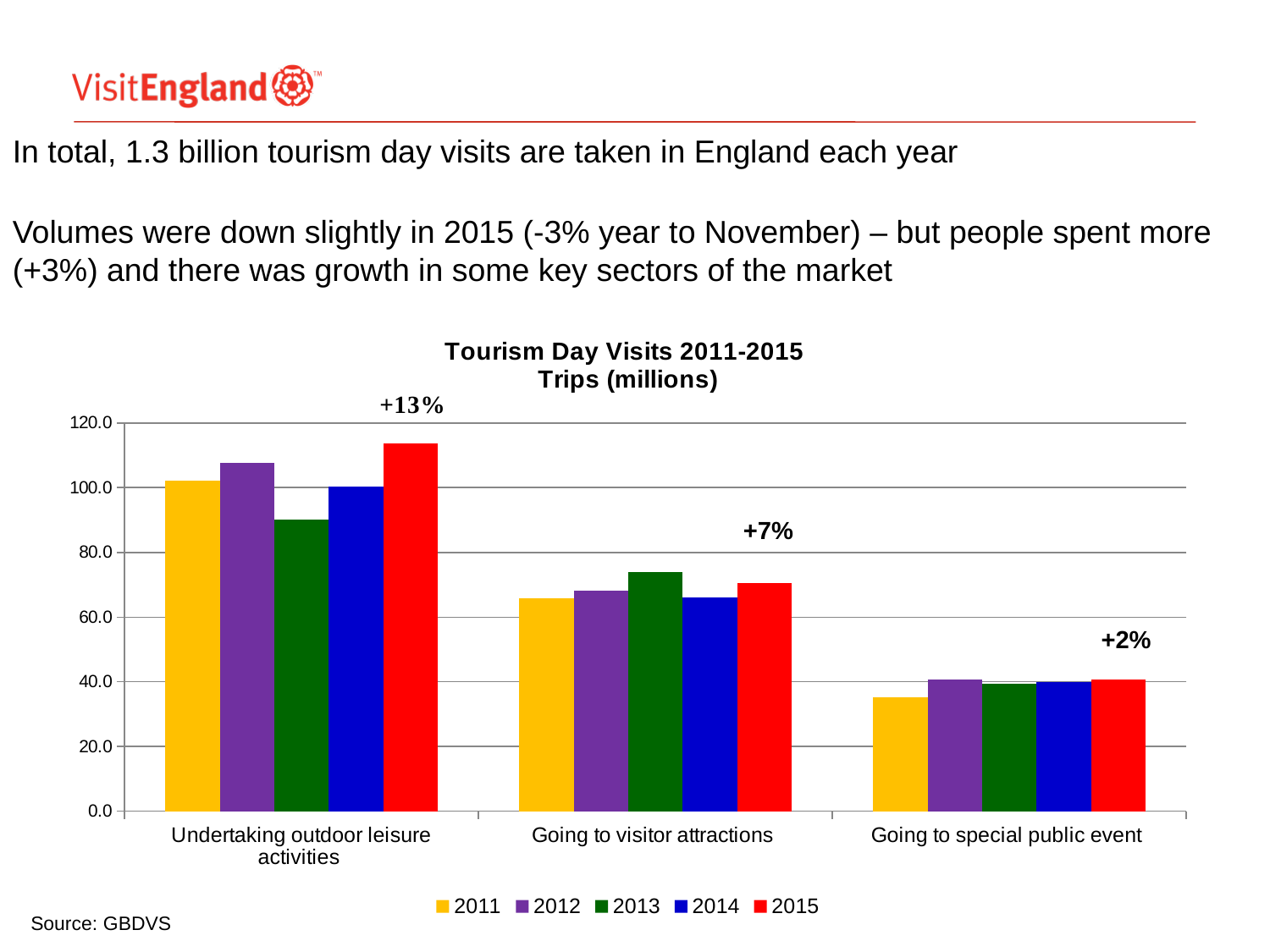
How many series does the chart legend list? 5 For 'Undertaking outdoor leisure activities', which year has more trips, 2013 or 2015? 2015 Which category has the lowest number of trips in 2011? Going to special public event What percentage change is printed above the 'Going to visitor attractions' group? +7% What percentage change is printed above the 'Undertaking outdoor leisure activities' group? +13% What percentage change is printed above the 'Going to special public event' group? +2% How many categories are shown on the x axis of the chart? 3 Is the 2015 value for 'Undertaking outdoor leisure activities' greater or less than 100.0? greater What is the title of the chart? Tourism Day Visits 2011-2015 Trips (millions) What kind of chart is shown on the slide? Bar chart Is the 2011 value for 'Going to special public event' greater or less than 40.0? less Which category has the highest number of trips in 2015? Undertaking outdoor leisure activities